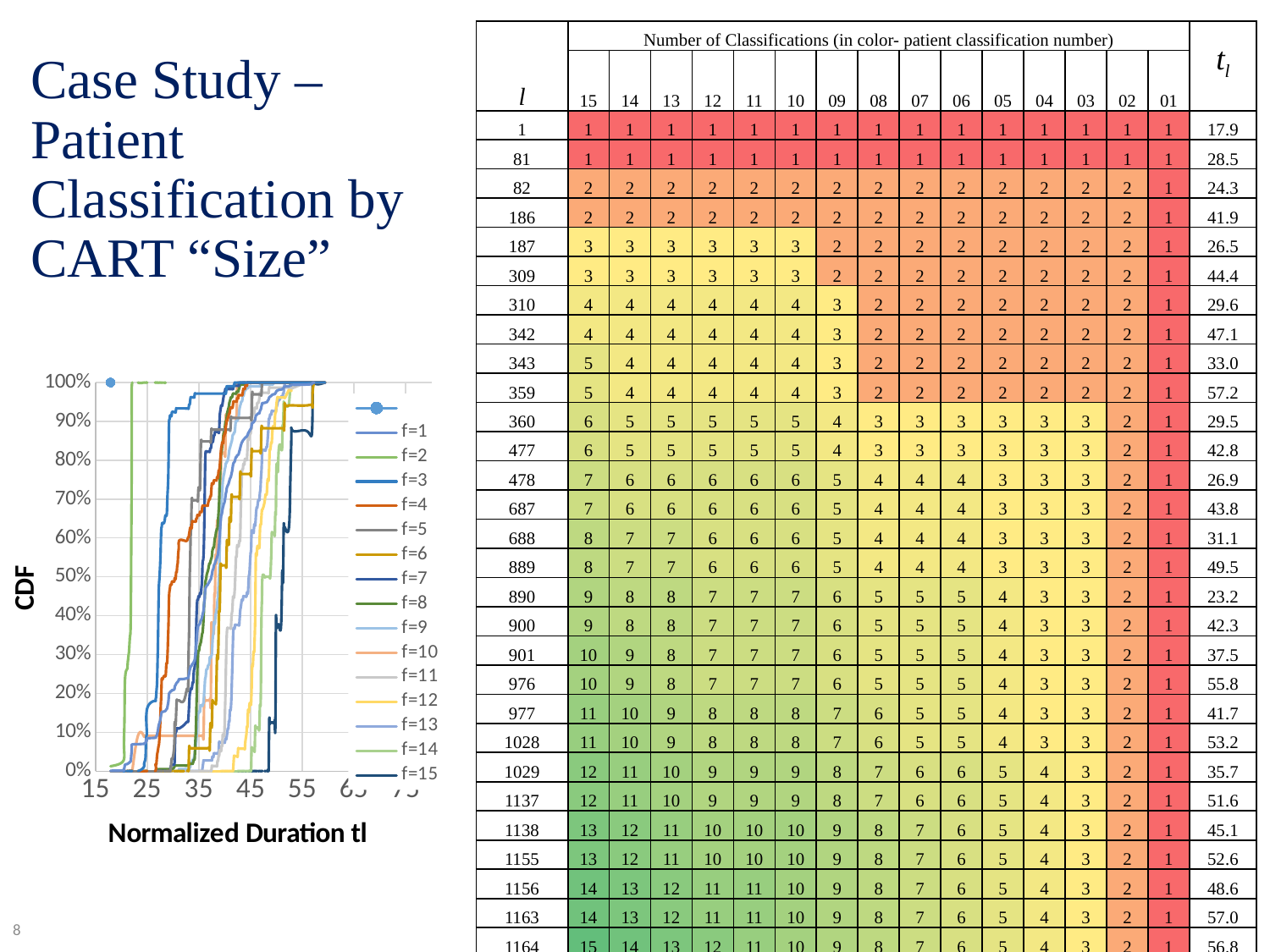
What is the label of the y axis on the chart? CDF What is the label of the x axis on the chart? Normalized Duration tl Do the CDF curves rise or fall as Normalized Duration tl increases along the x axis? rise What kind of chart is shown on the left of the slide? line chart What is the lowest tick value shown on the x axis of the chart? 15 How many series labelled f=1 through f=15 does the chart legend list? 15 What is the highest value shown on the y axis of the chart? 100%